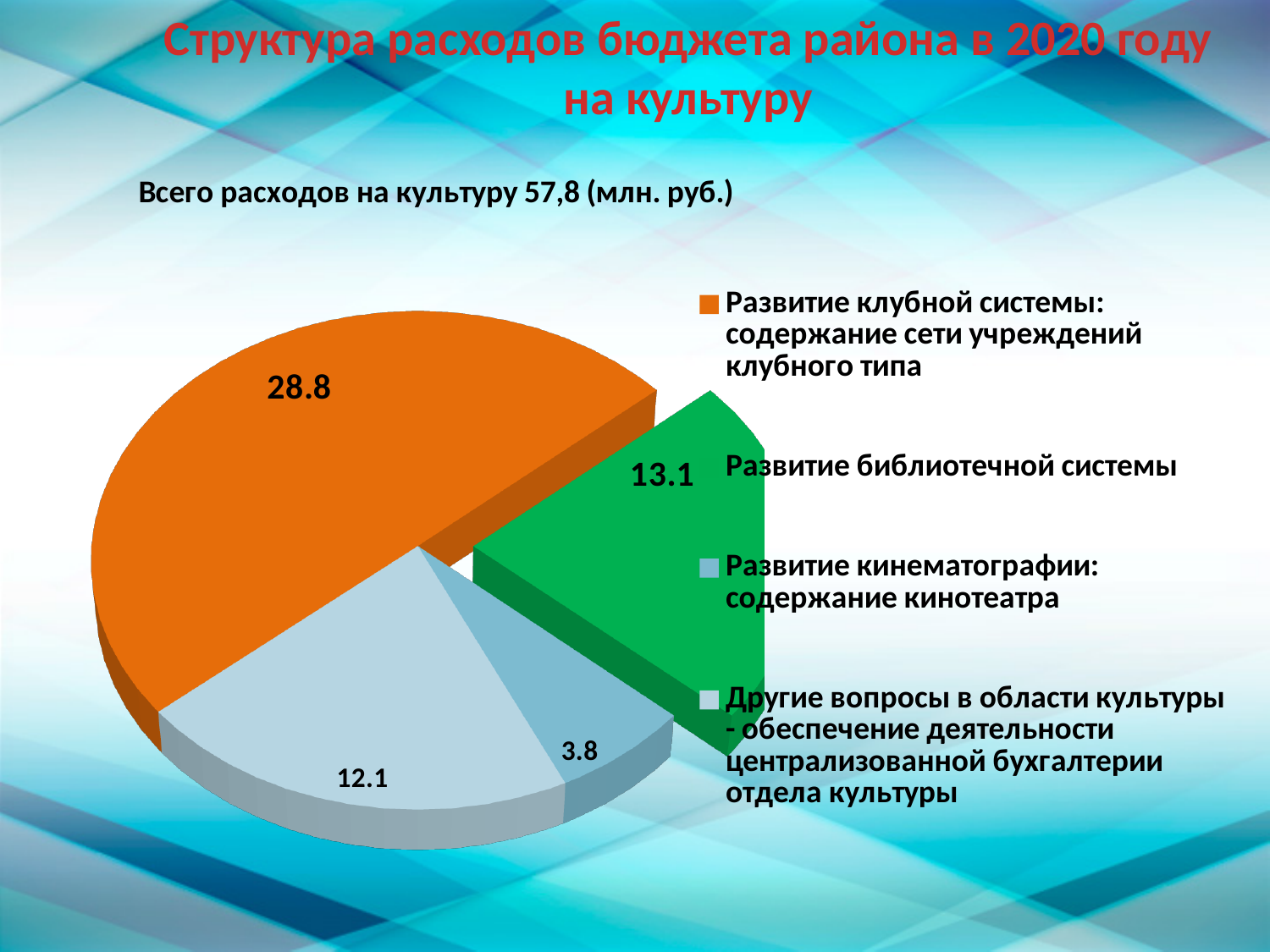
What is the total of all the slices in the pie chart? 57.8 Which category has the largest slice of the pie? Развитие клубной системы: содержание сети учреждений клубного типа What is the value for «Развитие кинематографии: содержание кинотеатра»? 3.8 How many slices does the pie chart have? 4 What is the difference between the values for «Развитие клубной системы» and «Развитие библиотечной системы»? 15.7 What colour is the slice for «Развитие библиотечной системы»? Green Which category has the smallest slice of the pie? Развитие кинематографии: содержание кинотеатра What is the value for «Развитие клубной системы: содержание сети учреждений клубного типа»? 28.8 Which is larger: the value for «Развитие библиотечной системы» or for «Другие вопросы в области культуры»? Развитие библиотечной системы What is the value for «Другие вопросы в области культуры - обеспечение деятельности централизованной бухгалтерии отдела культуры»? 12.1 What is the value for «Развитие библиотечной системы»? 13.1 What type of chart is shown on the slide? Pie chart